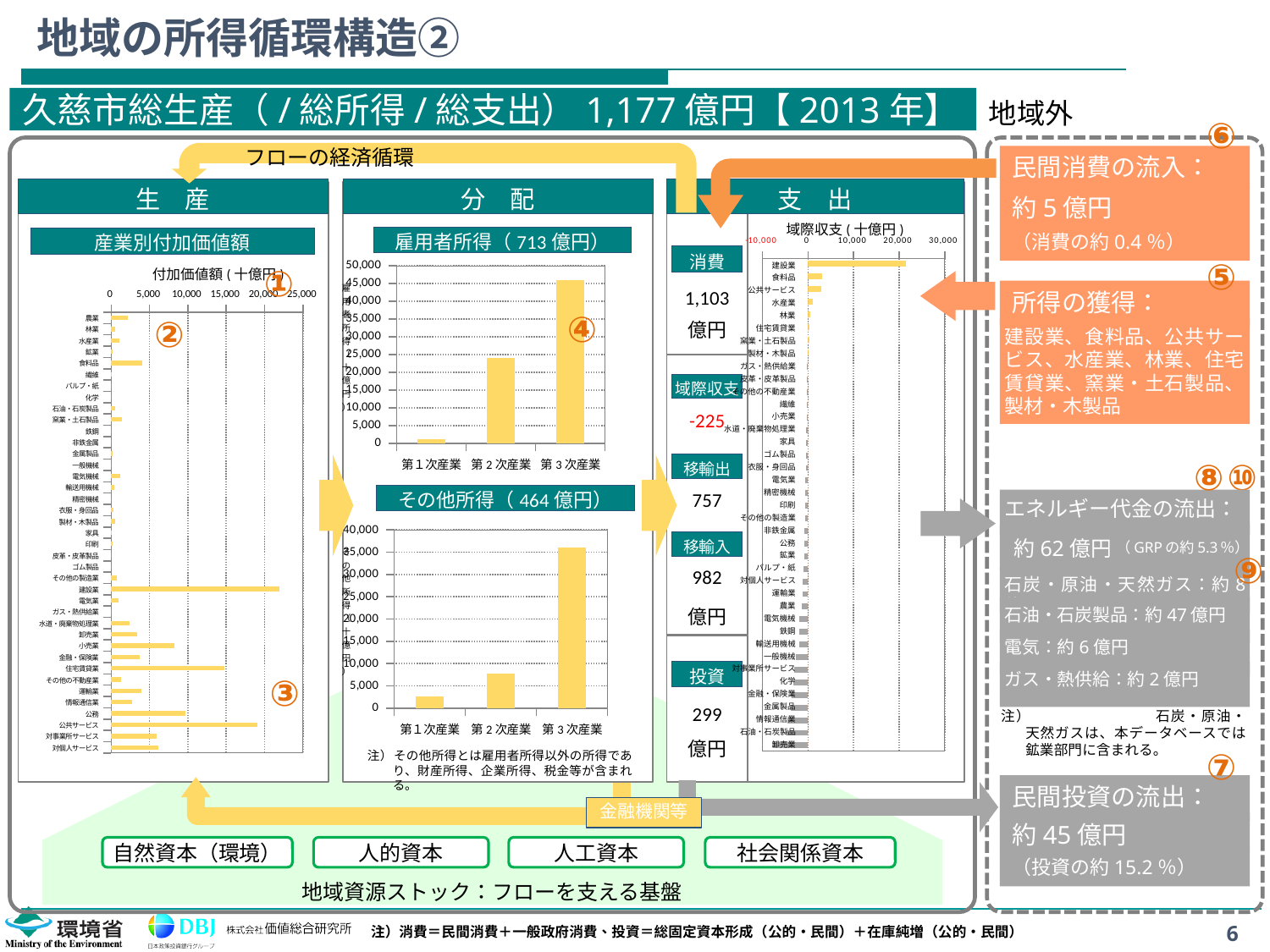
What kind of chart is the 雇用者所得 chart? bar chart In the その他所得 chart, is the value for 第３次産業 greater or less than 35,000? greater In the 域際収支 chart, which industry has the highest value? 建設業 In the その他所得 chart, do the values rise or fall from 第１次産業 to 第３次産業? rise In the 産業別付加価値額 chart, is the value for 建設業 greater or less than 20,000? greater In the 雇用者所得 chart, is the value for 第２次産業 greater or less than 25,000? less In the 雇用者所得 chart, which category has the highest value? 第３次産業 How many categories are shown in the その他所得 chart? 3 In the 産業別付加価値額 chart, which industry has the highest value? 建設業 In the 雇用者所得 chart, which category has the lowest value? 第１次産業